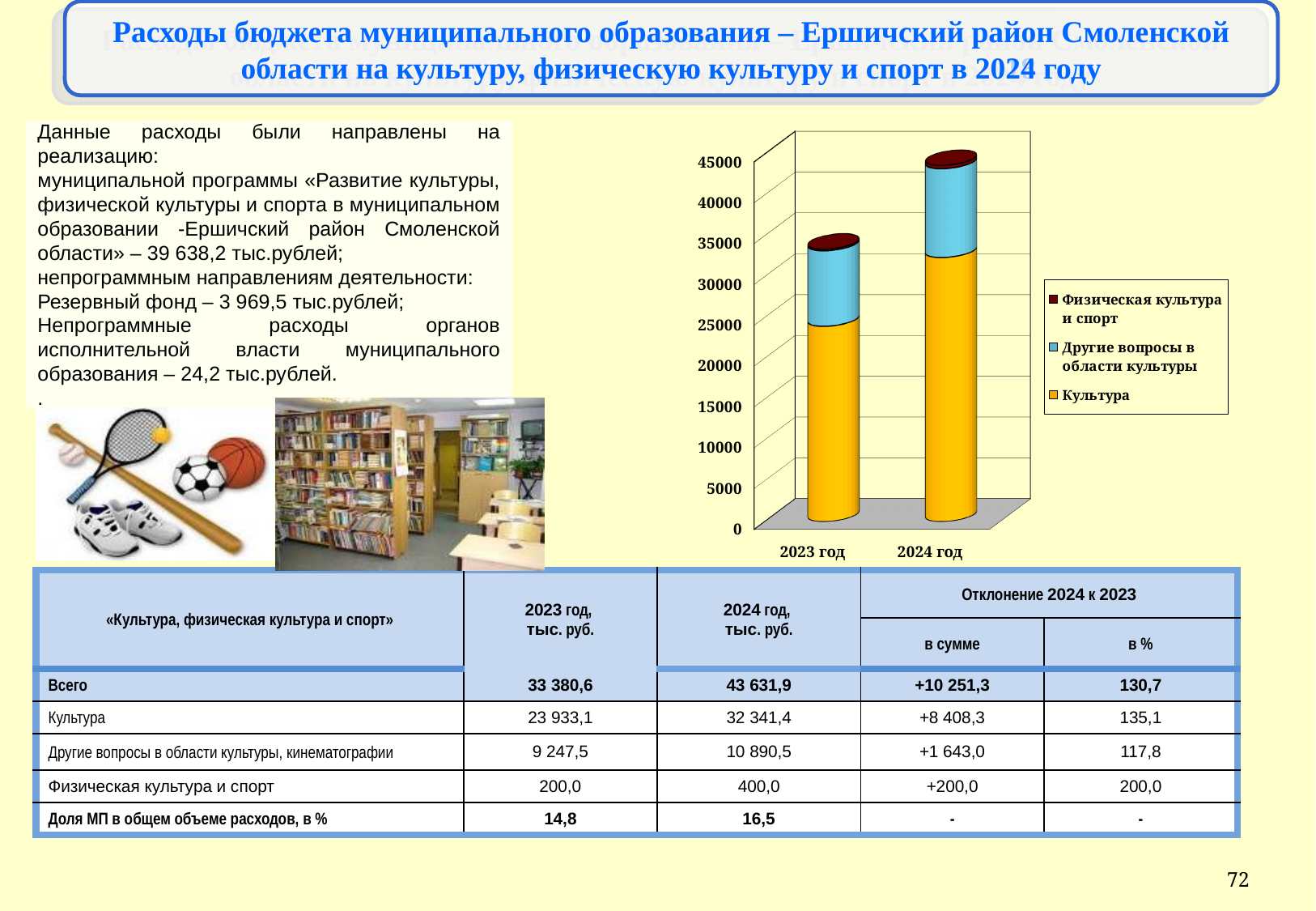
What kind of chart is shown on the slide? bar chart Which series is shown in yellow in the chart legend? Культура Do the stacked bar totals rise or fall from 2023 год to 2024 год? rise How many categories (years) are shown on the x axis of the chart? 2 Is the total stacked bar for 2023 год greater or less than 30000? greater How many series does the chart legend list? 3 Which year has the shorter stacked bar in the chart? 2023 год What is the highest value labelled on the chart's vertical axis? 45000 Which year has the taller stacked bar in the chart? 2024 год Is the total stacked bar for 2024 год greater or less than 40000? greater Is the Культура segment for 2024 год greater or less than 30000? greater